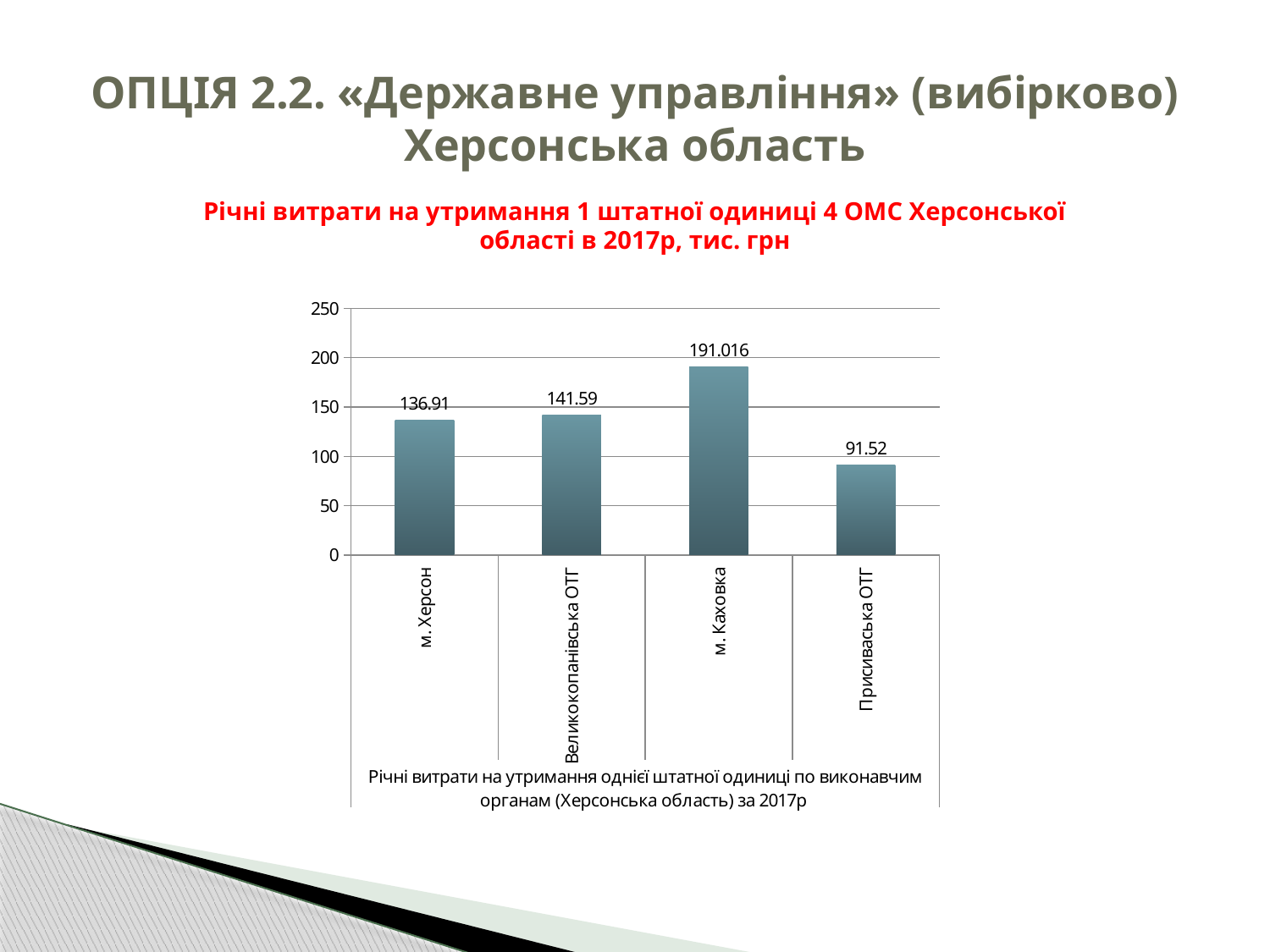
Which is larger, the value for м. Херсон or the value for Великокопанівська ОТГ? Великокопанівська ОТГ What is the value for Присиваська ОТГ? 91.52 Which category has the lowest value? Присиваська ОТГ What is the value for м. Каховка? 191.016 What is the value for Великокопанівська ОТГ? 141.59 Which category has the highest value? м. Каховка What is the difference between the values for м. Каховка and Присиваська ОТГ? 99.496 What is the value for м. Херсон? 136.91 How many categories are shown in the chart? 4 What is the title of the chart shown in red above it? Річні витрати на утримання 1 штатної одиниці 4 ОМС Херсонської області в 2017р, тис. грн What is the difference between the values for Великокопанівська ОТГ and м. Херсон? 4.68 What kind of chart is shown on the slide? Bar chart